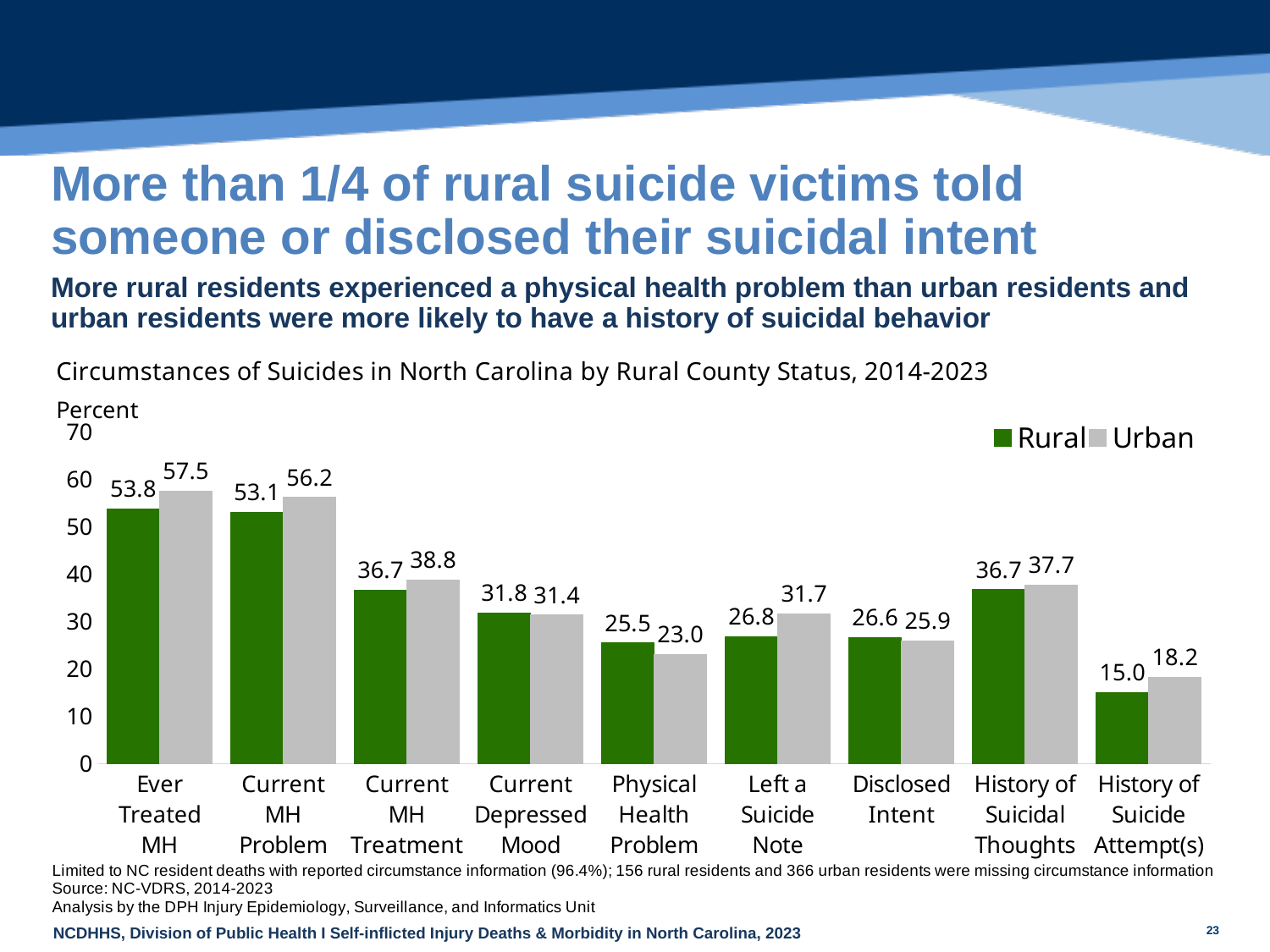
What is the Urban value for History of Suicide Attempt(s)? 18.2 Which category has the lowest Rural value? History of Suicide Attempt(s) How many circumstance categories are shown on the x axis? 9 What is the title of the chart? Circumstances of Suicides in North Carolina by Rural County Status, 2014-2023 Which is larger for Physical Health Problem, the Rural value or the Urban value? Rural What is the Rural value for Physical Health Problem? 25.5 Is the Rural value for Current MH Problem greater or less than 50? greater What kind of chart is shown on the slide? Bar chart What is the difference between the Urban and Rural values for Ever Treated MH? 3.7 How many series does the legend list? 2 What is the Urban value for Left a Suicide Note? 31.7 Which category has the highest Urban value? Ever Treated MH